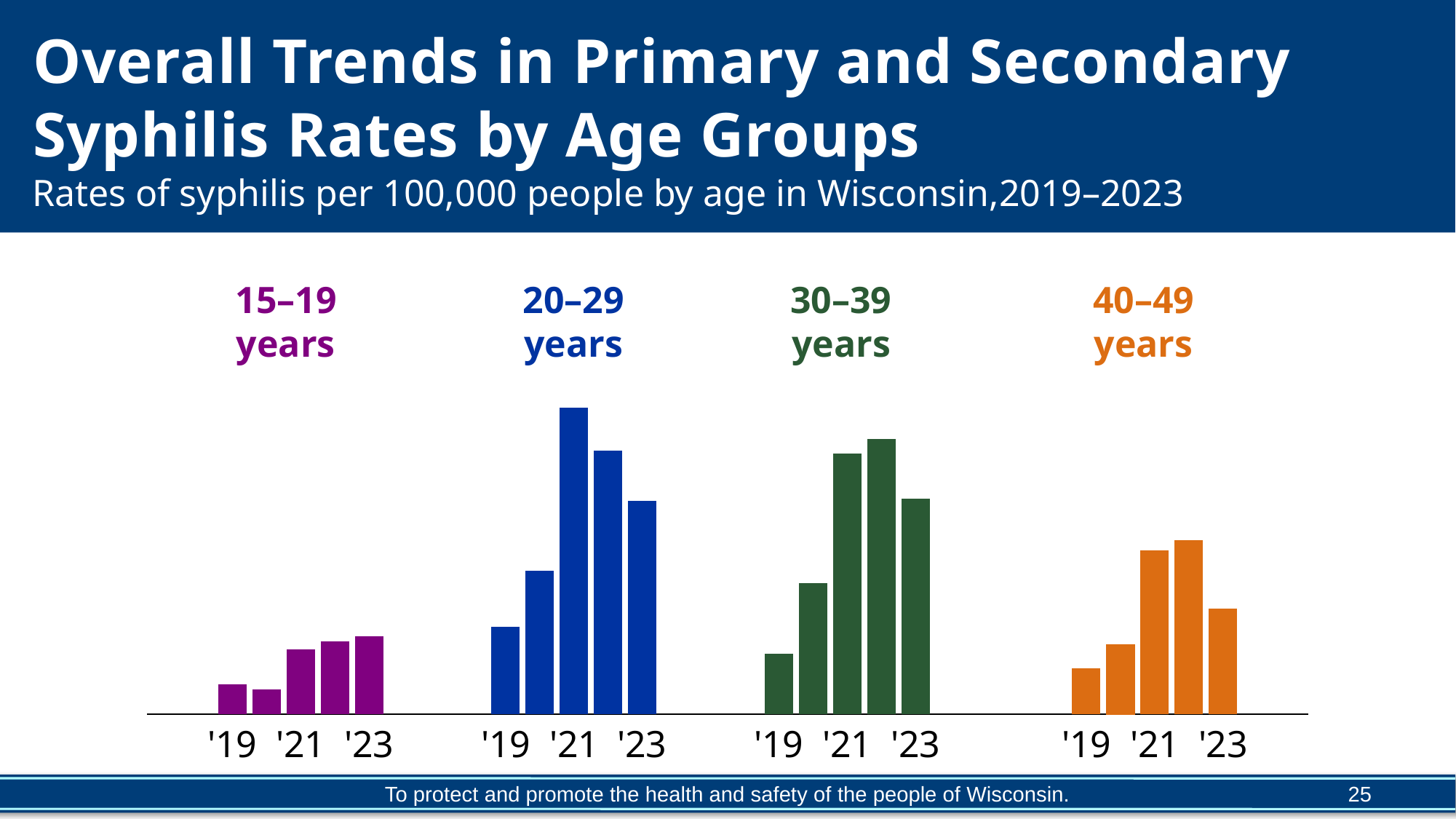
For the 30–39 years group, which year has the highest bar? '22 For the 15–19 years group, do the bars rise or fall from '21 to '23? Rise For the 20–29 years group, do the bars rise or fall from '21 to '23? Fall What kind of chart is shown on the slide? Bar chart How many age groups are shown on the chart? 4 Which is taller: the '23 bar for 15–19 years or the '23 bar for 40–49 years? 40–49 years How many bars are plotted for the 20–29 years age group? 5 Which age group is shown in orange? 40–49 years For the 40–49 years group, which year has the lowest bar? '19 For the 20–29 years group, which year has the lowest bar? '19 For the 20–29 years group, which year has the highest bar? '21 Which age group contains the tallest bar on the chart? 20–29 years